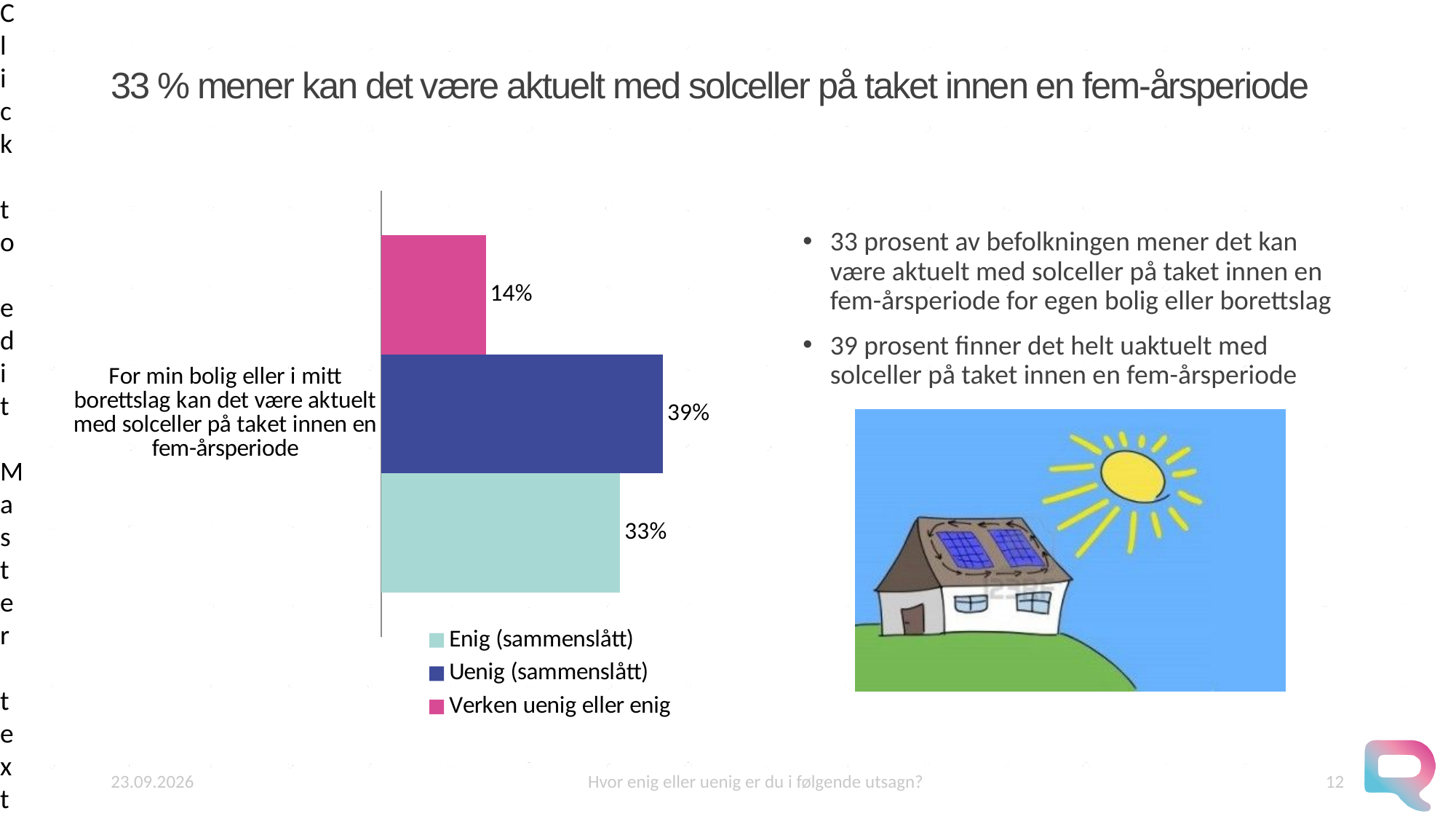
What is the category label shown to the left of the bars? For min bolig eller i mitt borettslag kan det være aktuelt med solceller på taket innen en fem-årsperiode How many series does the legend list? 3 What is the difference between the values for Enig (sammenslått) and Verken uenig eller enig? 19% What value is shown for Verken uenig eller enig? 14% What is the difference between the values for Uenig (sammenslått) and Enig (sammenslått)? 6% What value is shown for Enig (sammenslått)? 33% Which series has the lowest value? Verken uenig eller enig What value is shown for Uenig (sammenslått)? 39% Which series has the highest value? Uenig (sammenslått) What kind of chart is shown on the slide? Bar chart What colour is the bar for Uenig (sammenslått)? Dark blue Which is larger, the value for Enig (sammenslått) or the value for Verken uenig eller enig? Enig (sammenslått)